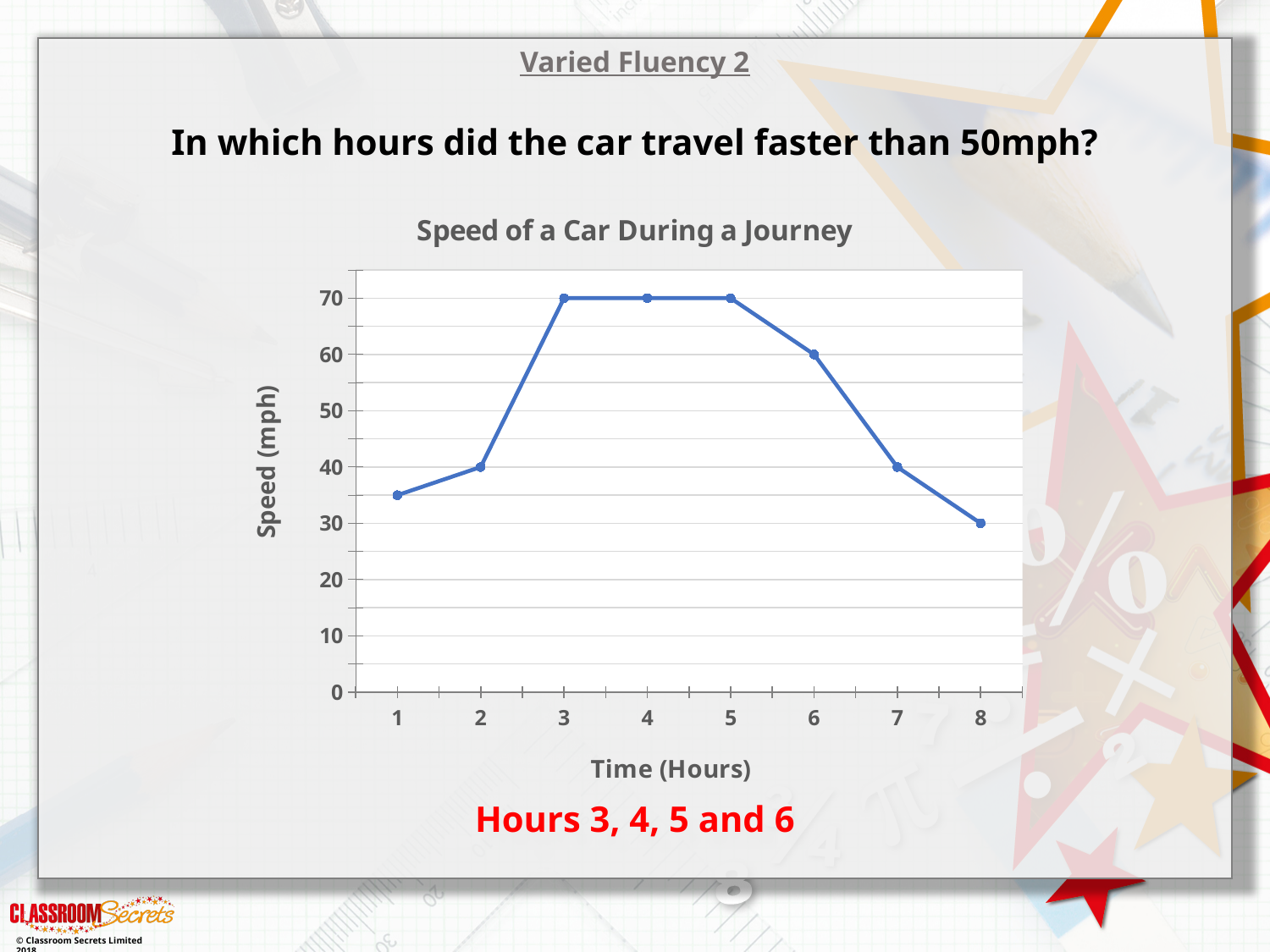
Is the speed at hour 1 greater or less than 50? less What kind of chart is shown on the slide? line chart Is the speed at hour 6 greater or less than 50? greater What is the difference in speed between hour 5 and hour 7? 30 What is the speed of the car at hour 8? 30 Does the speed rise or fall between hour 5 and hour 8? fall What is the speed of the car at hour 6? 60 At which hour is the car's speed lowest? 8 What is the title of the chart? Speed of a Car During a Journey What is the speed of the car at hour 4? 70 What is the speed of the car at hour 2? 40 How many hours are plotted on the x axis? 8